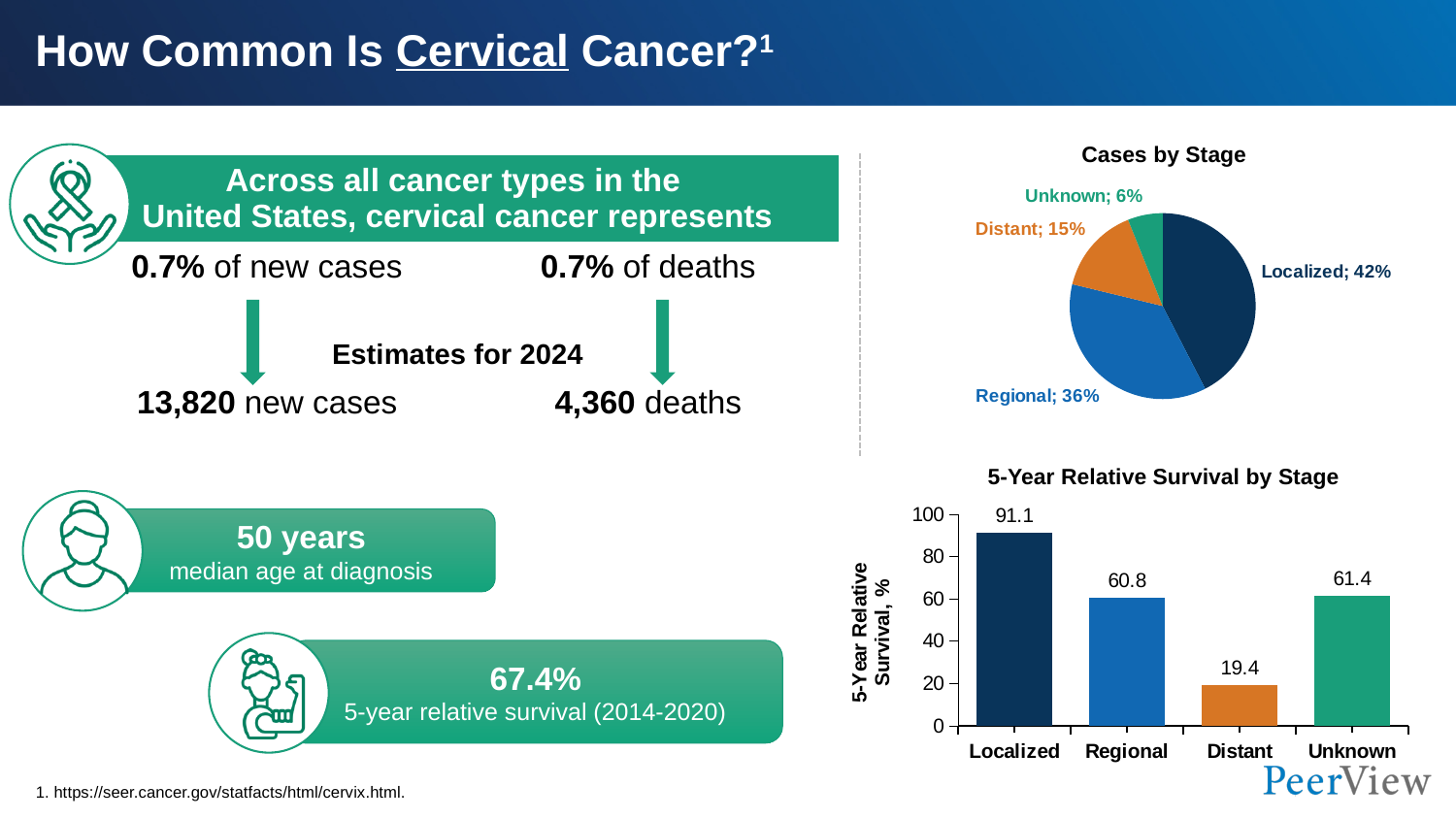
In the '5-Year Relative Survival by Stage' chart, what is the difference between the Localized and Regional values? 30.3 In the '5-Year Relative Survival by Stage' chart, what is the y-axis label? 5-Year Relative Survival, % In the 'Cases by Stage' chart, what is the difference between the Regional and Distant shares? 21% In the '5-Year Relative Survival by Stage' chart, what is the value for Localized? 91.1 In the 'Cases by Stage' chart, what kind of chart is shown? Pie chart In the 'Cases by Stage' chart, what share of cases is Localized? 42% In the '5-Year Relative Survival by Stage' chart, what is the value for Distant? 19.4 In the '5-Year Relative Survival by Stage' chart, which stage has the lowest 5-year relative survival? Distant In the 'Cases by Stage' chart, how many slices does the pie have? 4 In the '5-Year Relative Survival by Stage' chart, what kind of chart is shown? Bar chart In the 'Cases by Stage' chart, which stage has the smallest share of cases? Unknown In the '5-Year Relative Survival by Stage' chart, which is larger, the value for Regional or the value for Distant? Regional